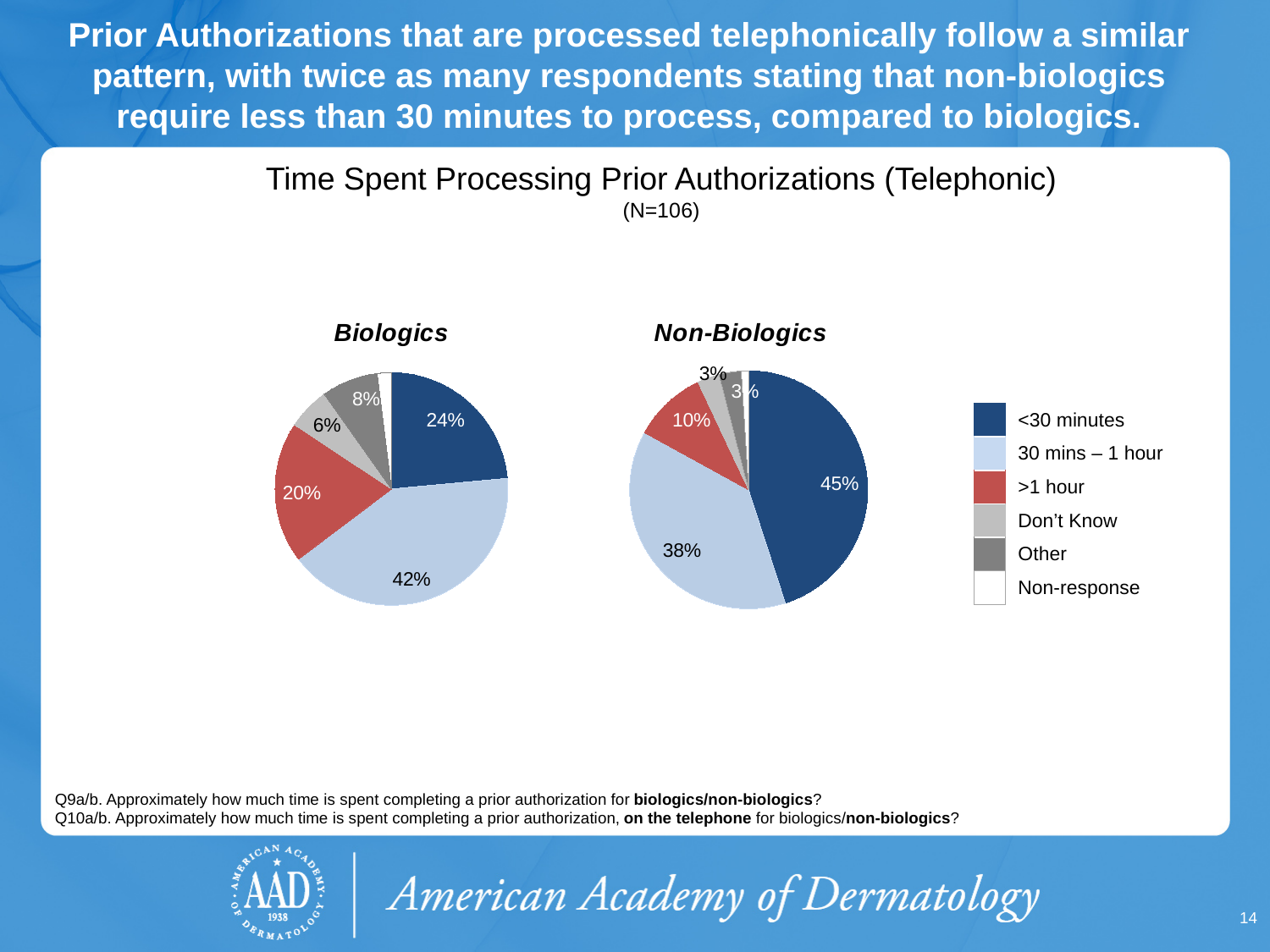
What type of chart is used to show Time Spent Processing Prior Authorizations (Telephonic)? Pie chart In the Biologics pie chart, what percentage of respondents said prior authorizations take 30 mins – 1 hour? 42% What is the sample size (N) shown under the chart title? N=106 In the Biologics pie chart, what percentage of respondents said prior authorizations take >1 hour? 20% Which is larger: the >1 hour share in the Biologics pie chart or the >1 hour share in the Non-Biologics pie chart? Biologics In the Non-Biologics pie chart, what percentage of respondents said prior authorizations take >1 hour? 10% In the Biologics pie chart, what percentage of respondents answered Other? 8% How many categories does the legend list for the pie charts? 6 In the Non-Biologics pie chart, what percentage of respondents said prior authorizations take <30 minutes? 45% In the Biologics pie chart, which category has the largest share? 30 mins – 1 hour What is the difference between the <30 minutes share in the Non-Biologics pie chart and the <30 minutes share in the Biologics pie chart? 21 percentage points In the Non-Biologics pie chart, which category has the largest share? <30 minutes